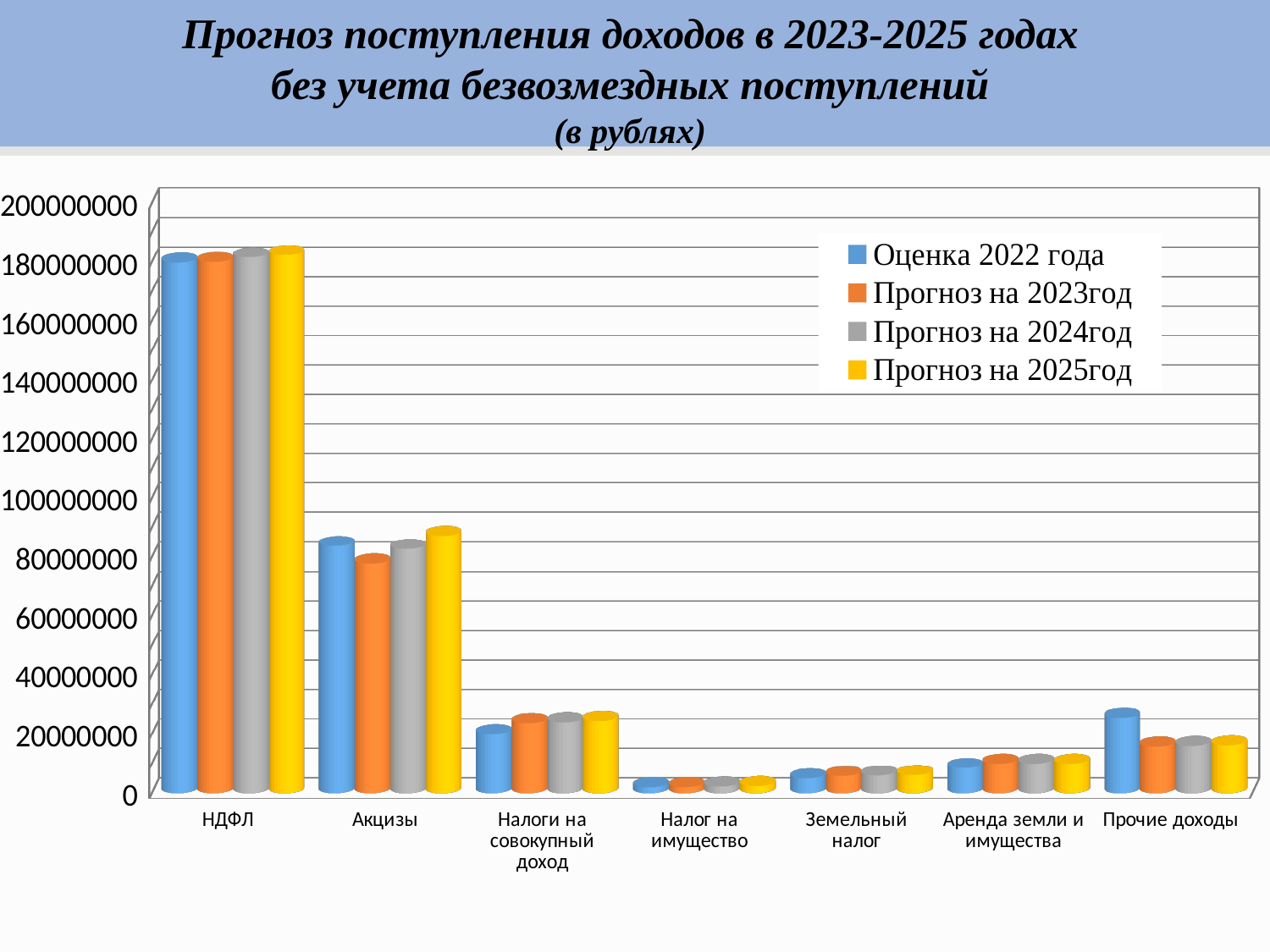
What kind of chart is shown on the slide? Bar chart Is the value for Акцизы in Прогноз на 2025год greater or less than 80000000? greater Is the value for Прочие доходы in Оценка 2022 года greater or less than 20000000? greater Which colour represents Прогноз на 2024год in the legend? Grey Is the value for НДФЛ in Оценка 2022 года greater or less than 160000000? greater Which category has the highest value for Оценка 2022 года? НДФЛ How many series does the legend list? 4 For Акцизы, which is larger: Прогноз на 2023год or Прогноз на 2025год? Прогноз на 2025год How many categories are shown on the x axis? 7 For Прочие доходы, which is larger: Оценка 2022 года or Прогноз на 2023год? Оценка 2022 года Which category has the lowest value for Прогноз на 2025год? Налог на имущество